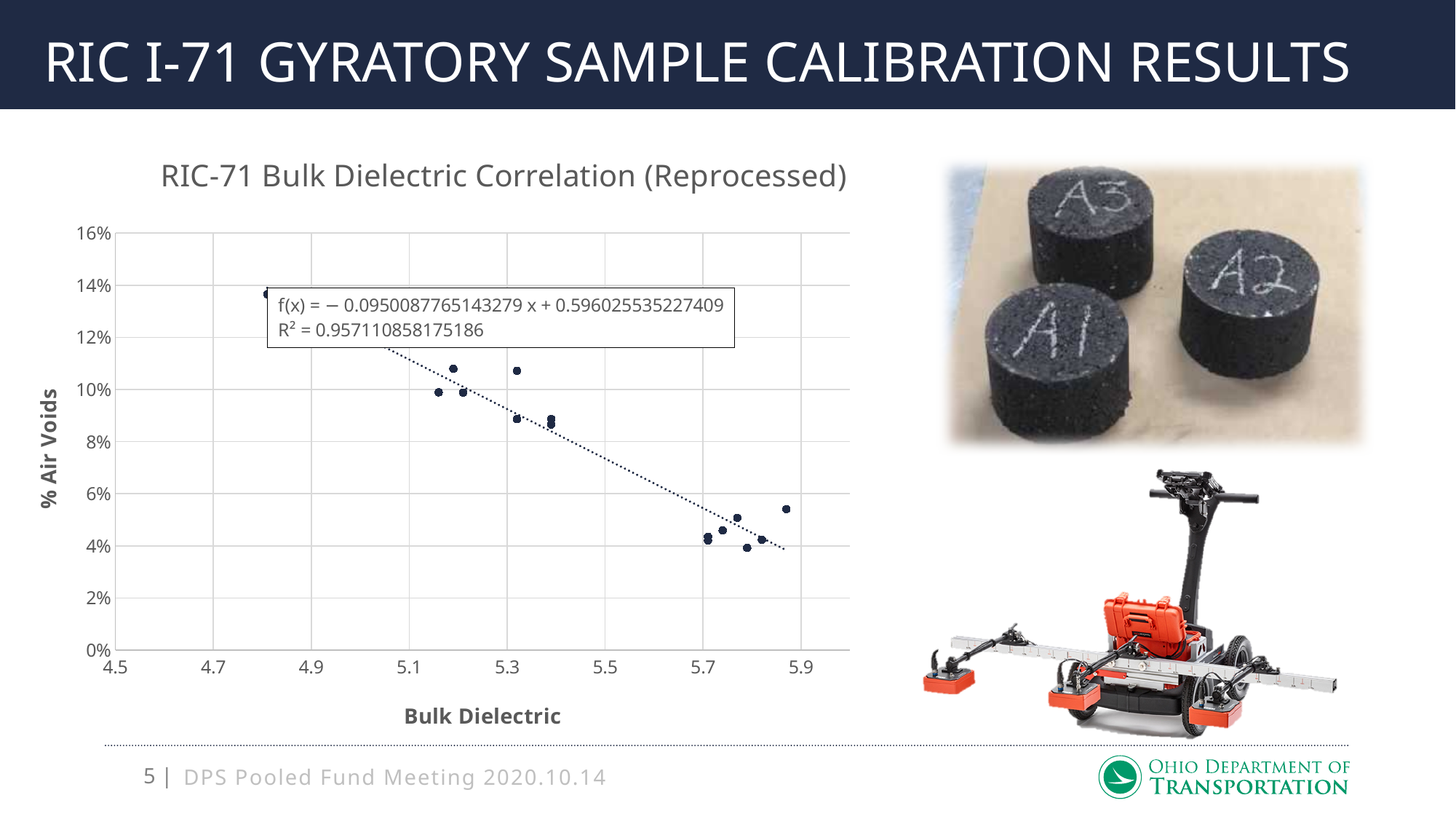
Is the slope of the fitted trendline positive or negative? negative What kind of chart is shown on the slide? scatter chart As bulk dielectric increases along the x axis, do the % air voids values rise or fall? fall Is the % air voids value of the highest point on the chart greater or less than 12%? greater Does the point with the highest % air voids have the lowest or the highest bulk dielectric on the chart? lowest What is the intercept term in the trendline equation printed on the chart? 0.596025535227409 What is the label of the vertical axis of the chart? % Air Voids Is the % air voids value of the lowest point on the chart greater or less than 6%? less What R² value is printed on the chart? 0.957110858175186 Which group of points has higher % air voids: those with bulk dielectric near 5.2 or those with bulk dielectric near 5.8? those near 5.2 What is the title of the chart? RIC-71 Bulk Dielectric Correlation (Reprocessed) Is the % air voids value of the rightmost point (bulk dielectric near 5.9) greater or less than 6%? less